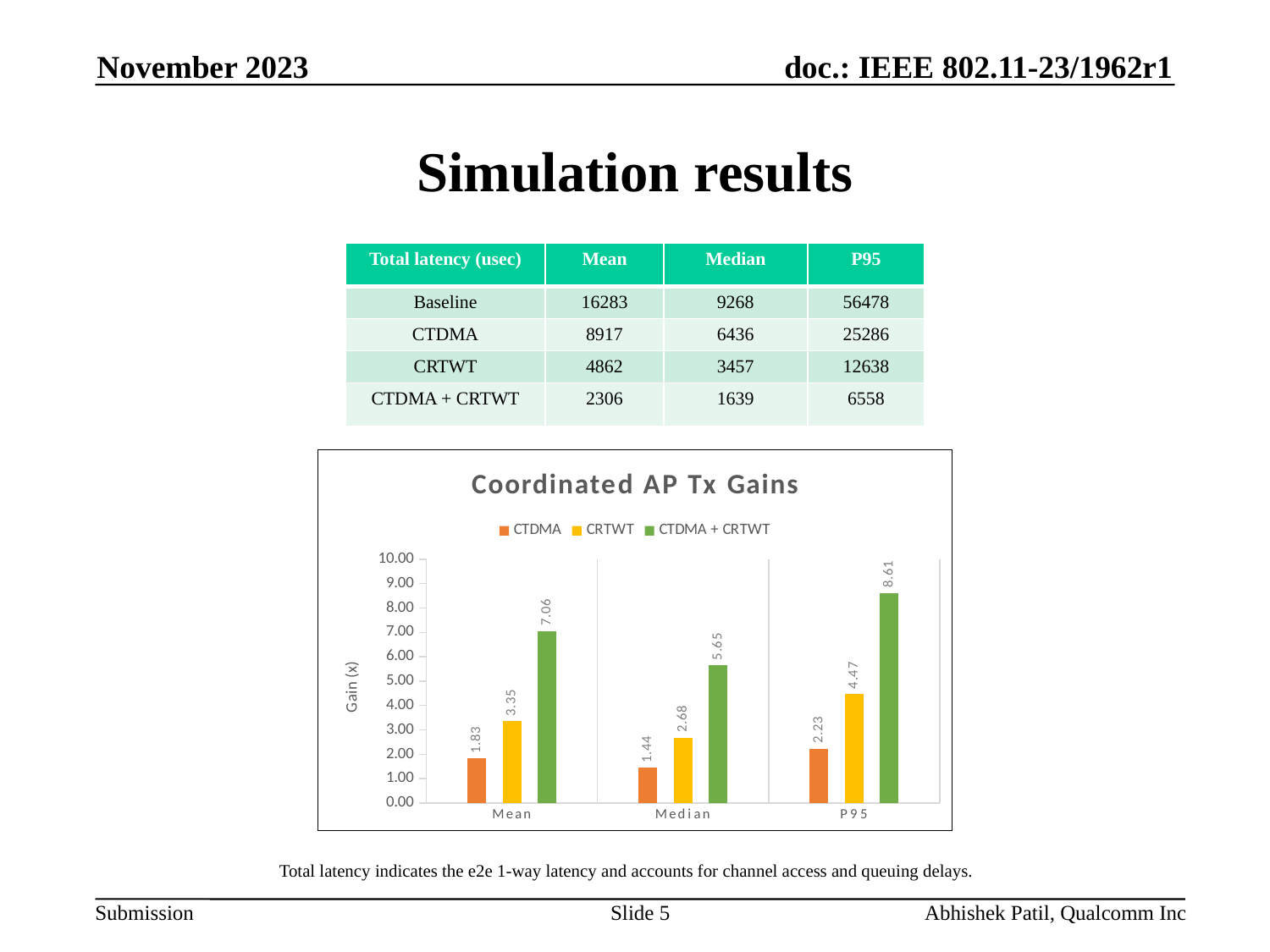
Which category has the lowest gain for CTDMA? Median Which category has the highest gain for CTDMA + CRTWT? P95 What kind of chart is shown on the slide? bar chart What is the gain for CTDMA + CRTWT in the P95 category? 8.61 How many categories are shown on the x axis of the chart? 3 How many series does the chart legend list? 3 What is the title of the chart? Coordinated AP Tx Gains What is the gain for CTDMA in the Mean category? 1.83 Is the CTDMA + CRTWT gain in the Median category greater or less than 5.00? greater Which is larger in the P95 category: the CRTWT gain or the CTDMA gain? CRTWT What is the gain for CRTWT in the Median category? 2.68 What is the difference between the CTDMA + CRTWT gain and the CTDMA gain in the Mean category? 5.23